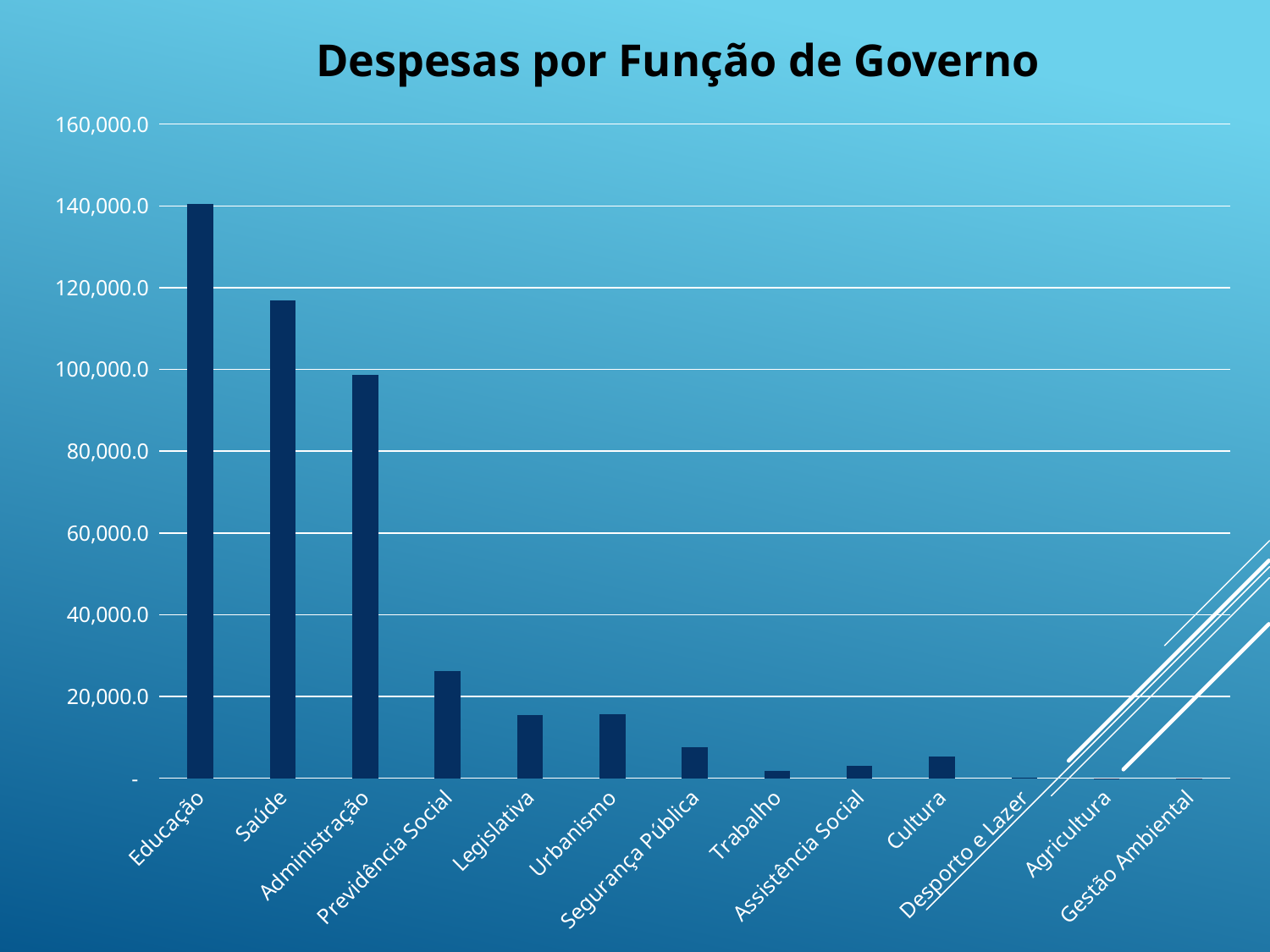
How many categories are shown on the x axis? 13 Is the value for Saúde greater or less than 100,000.0? greater Is the value for Previdência Social greater or less than 20,000.0? greater What kind of chart is shown on the slide? bar chart What is the title of the chart? Despesas por Função de Governo Is the value for Administração greater or less than 120,000.0? less Which is larger, the value for Cultura or the value for Assistência Social? Cultura Which is larger, the value for Saúde or the value for Administração? Saúde Which is larger, the value for Previdência Social or the value for Legislativa? Previdência Social Which category has the highest value? Educação